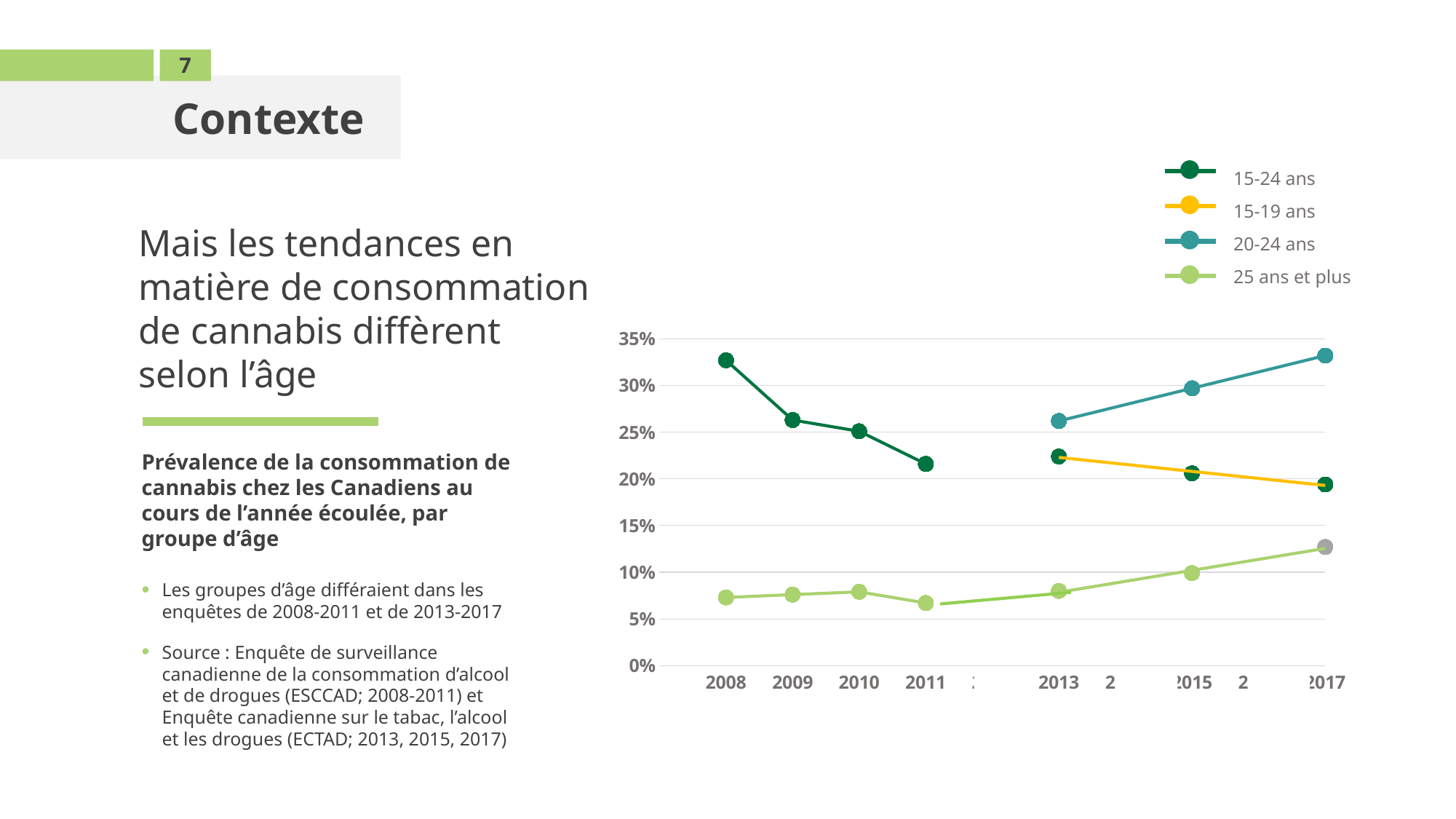
Is the value for 20-24 ans in 2017 greater or less than 30%? greater Does the value for 20-24 ans rise or fall from 2013 to 2017? rise Is the value for 15-24 ans in 2008 greater or less than 30%? greater Which age groups are listed in the chart legend? 15-24 ans, 15-19 ans, 20-24 ans, 25 ans et plus Which age group has the lowest values across all years shown? 25 ans et plus Is the value for 25 ans et plus in 2008 greater or less than 10%? less What kind of chart is shown on the slide? line chart In 2013, which is larger: the value for 20-24 ans or the value for 15-19 ans? 20-24 ans How many series does the legend list? 4 Does the value for 15-24 ans rise or fall from 2008 to 2011? fall Does the value for 15-19 ans rise or fall from 2013 to 2017? fall